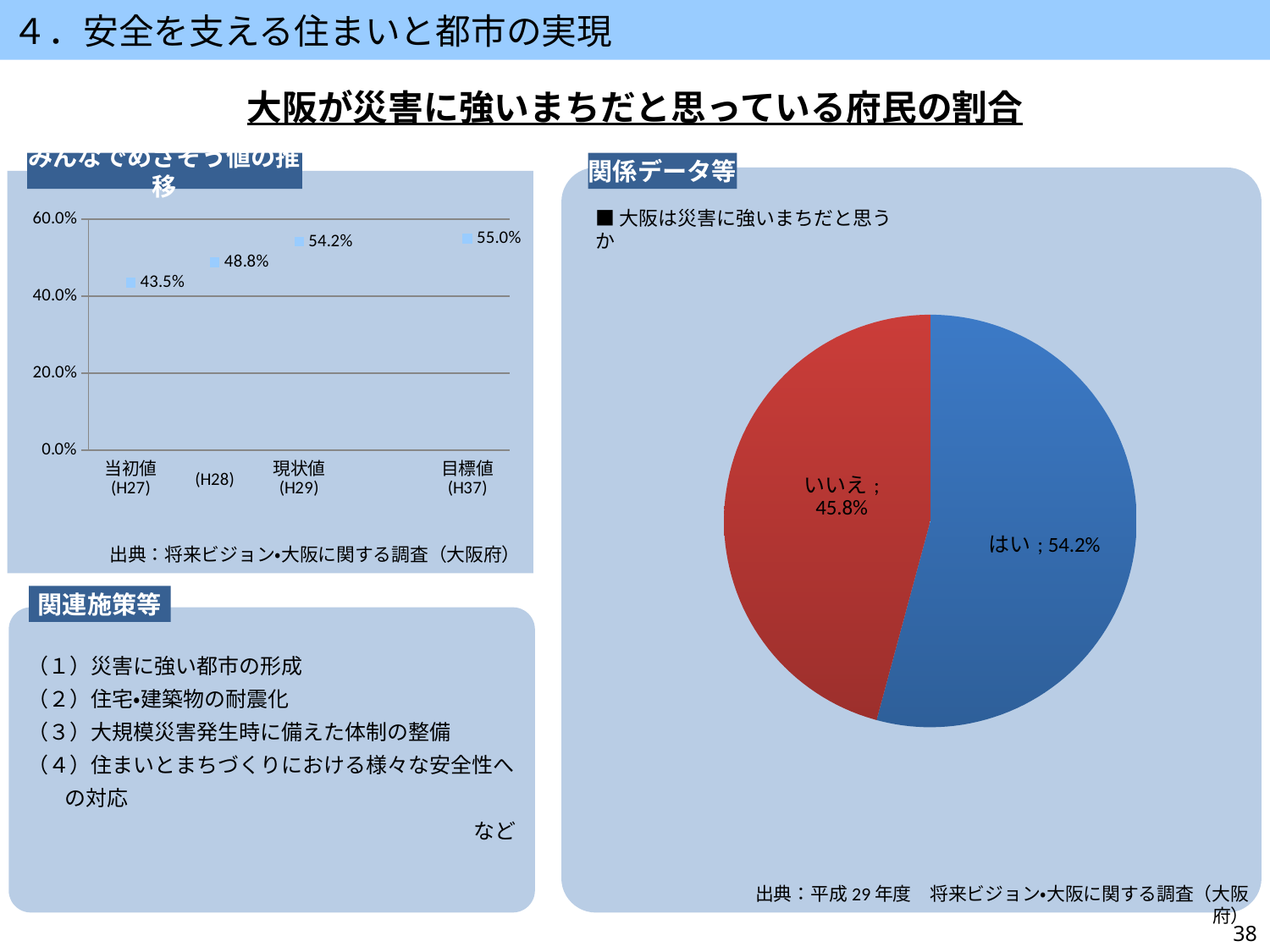
In the left chart (みんなでめざそう値の推移), do the values rise or fall from H27 to H37? rise In the left chart (みんなでめざそう値の推移), what is the value for 目標値 (H37)? 55.0% In the left chart (みんなでめざそう値の推移), what is the value for H28? 48.8% In the left chart (みんなでめざそう値の推移), what is the difference between the 目標値 (H37) and the 当初値 (H27)? 11.5% What kind of chart is shown on the right side of the slide under 関係データ等? pie chart In the pie chart on the right, what share is labelled はい? 54.2% In the pie chart on the right, what share is labelled いいえ? 45.8% In the pie chart on the right, which slice is larger, はい or いいえ? はい In the left chart (みんなでめざそう値の推移), which point has the lowest value? 当初値 (H27) In the left chart (みんなでめざそう値の推移), what is the value for 現状値 (H29)? 54.2% In the left chart (みんなでめざそう値の推移), what is the value for 当初値 (H27)? 43.5% In the left chart (みんなでめざそう値の推移), how many data points are plotted? 4